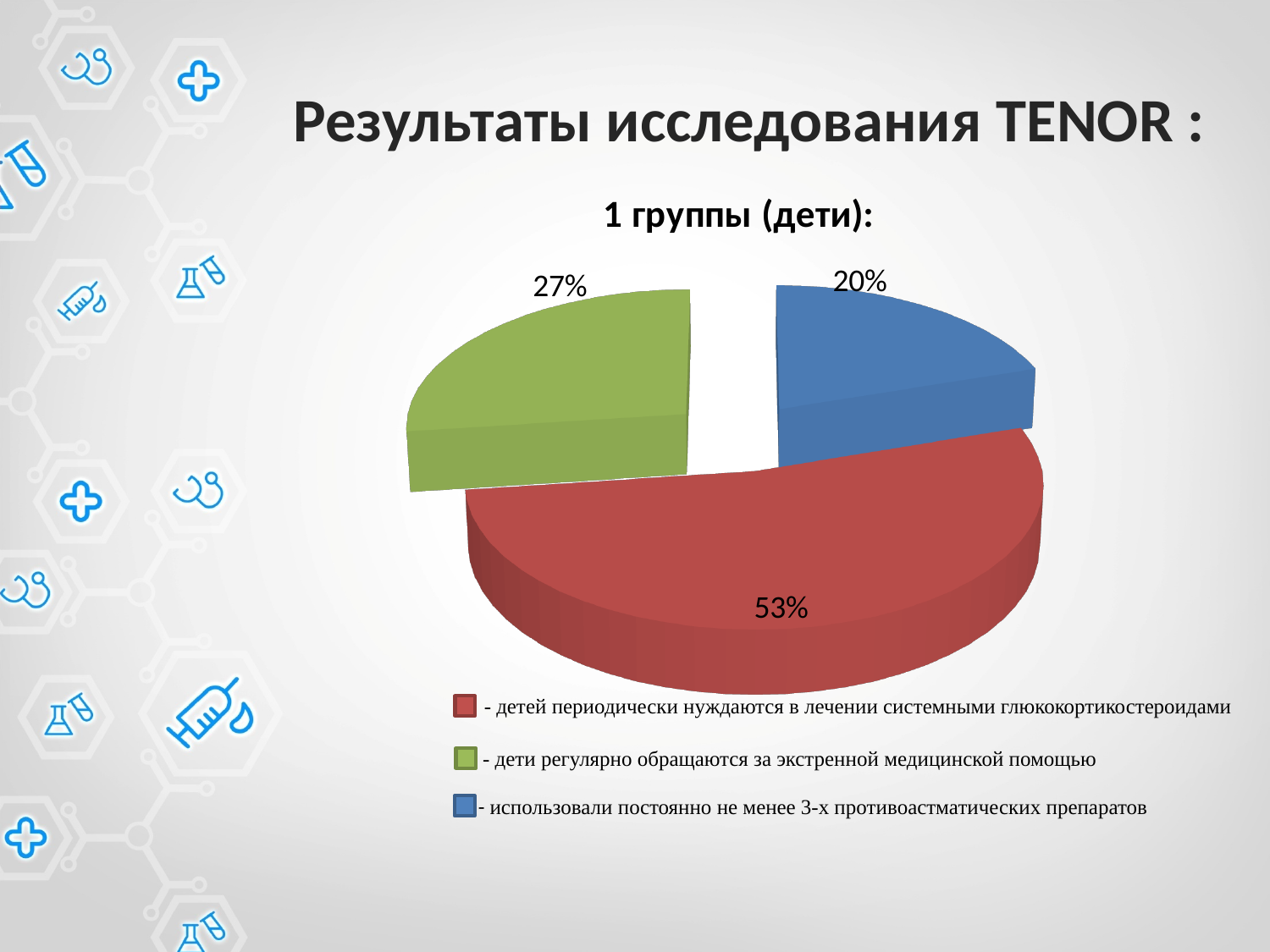
What share of the pie is the red slice (children who periodically need treatment with systemic glucocorticosteroids)? 53% What share of the pie is the green slice (children who regularly seek emergency medical care)? 27% What is the difference between the largest slice and the smallest slice? 33% What is the title of the chart? 1 группы (дети): What kind of chart is shown on the slide? pie chart How many slices does the pie chart have? 3 What is the difference between the green slice and the blue slice? 7% How many entries does the legend list? 3 What share of the pie is the blue slice (used at least 3 anti-asthma drugs constantly)? 20% Which slice of the pie is the largest? 53% (red) - детей периодически нуждаются в лечении системными глюкокортикостероидами Which is larger: the green slice or the blue slice? the green slice (27%) Which slice of the pie is the smallest? 20% (blue) - использовали постоянно не менее 3-х противоастматических препаратов